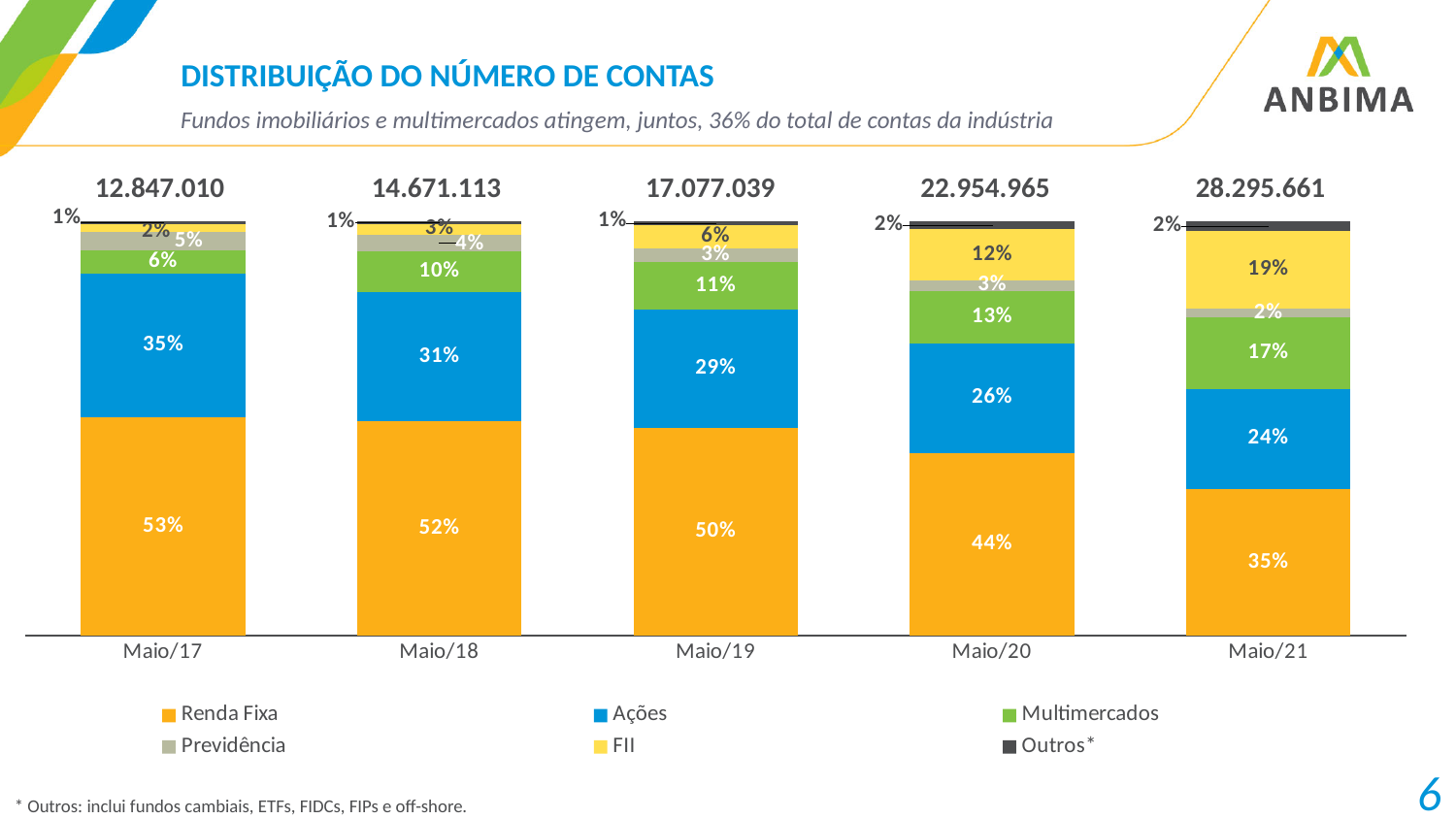
What is the Multimercados share in Maio/18? 10% Does the Renda Fixa share rise or fall from Maio/17 to Maio/21? Fall What is the FII share in Maio/20? 12% What kind of chart is shown on the slide? Stacked bar chart How many series does the legend list? 6 By how many percentage points did the Ações share fall from Maio/17 to Maio/21? 11 percentage points Which is larger in Maio/21, the FII share or the Multimercados share? FII How many periods are shown on the x axis? 5 What share of accounts does Renda Fixa hold in Maio/21? 35% In which period is the FII share lowest? Maio/17 In which period is the Renda Fixa share highest? Maio/17 What total number of accounts is shown above the Maio/19 bar? 17.077.039